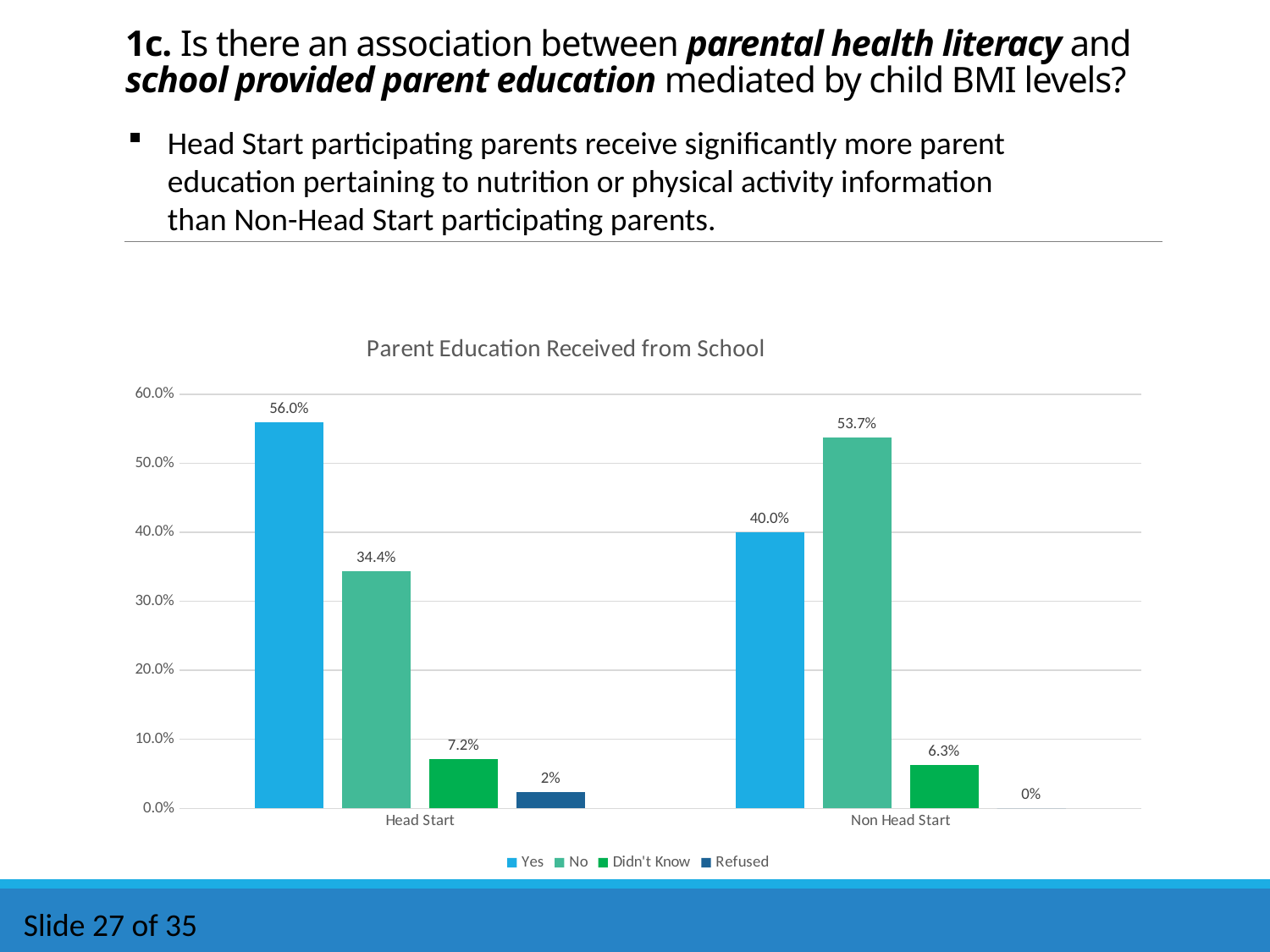
What is the difference between the Yes values for Head Start and Non Head Start? 16.0% What is the value for Refused in the Non Head Start group? 0% What kind of chart is shown on the slide? Bar chart Which series has the highest value in the Non Head Start group? No What is the value for Yes in the Head Start group? 56.0% What is the title of the chart? Parent Education Received from School Which is larger: the No value for Head Start or the No value for Non Head Start? Non Head Start What is the value for No in the Non Head Start group? 53.7% What is the value for Didn't Know in the Head Start group? 7.2% How many categories are shown on the x axis? 2 Which series has the lowest value in the Head Start group? Refused How many series does the legend list? 4